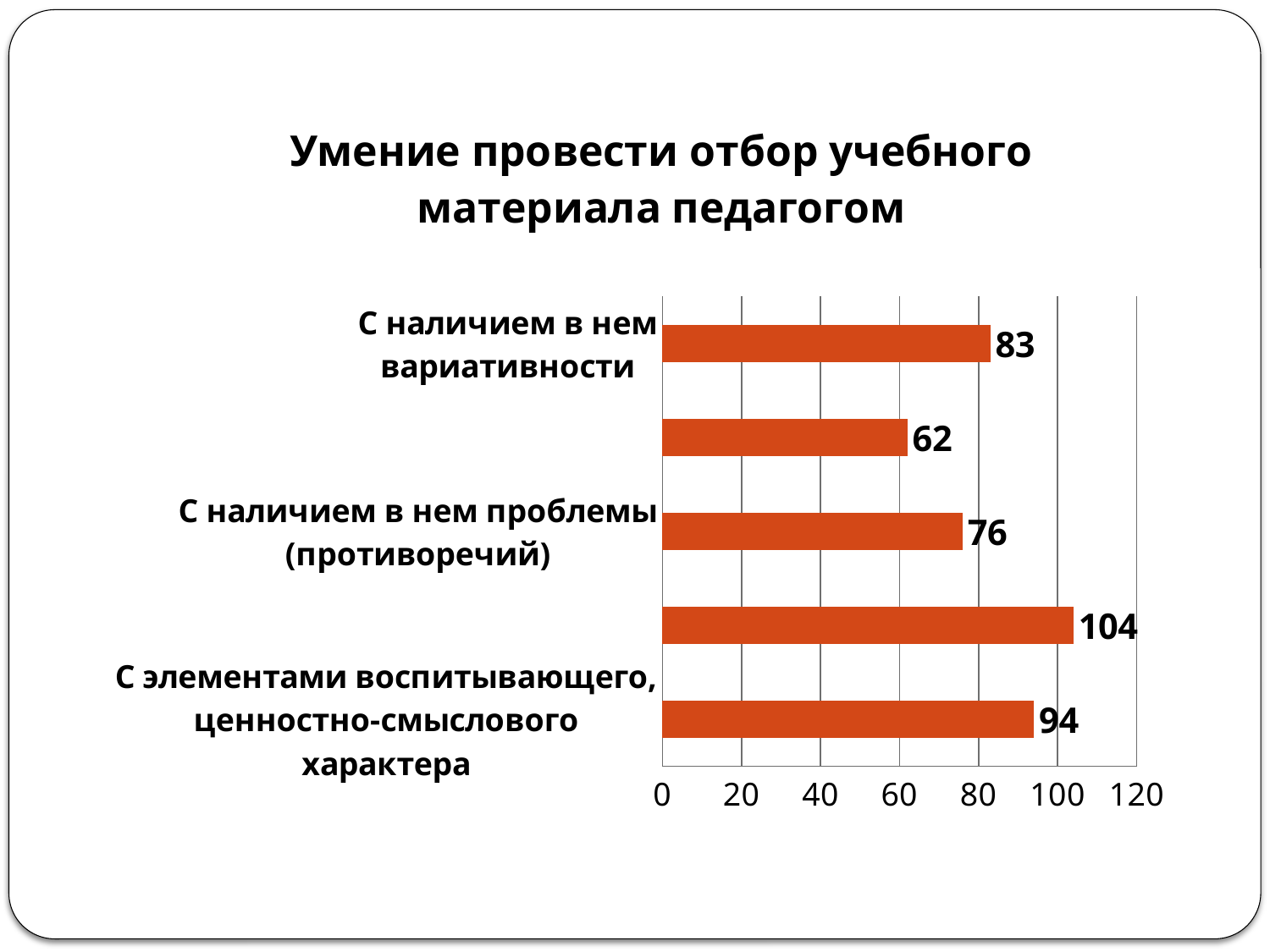
What is the value of the second bar from the top? 62 What is the value for "С элементами воспитывающего, ценностно-смыслового характера"? 94 What is the value for "С наличием в нем вариативности"? 83 What is the highest value shown on the chart? 104 How many bars are plotted on the chart? 5 Which is larger: the value for "С наличием в нем вариативности" or the value for "С наличием в нем проблемы (противоречий)"? С наличием в нем вариативности What is the value for "С наличием в нем проблемы (противоречий)"? 76 What kind of chart is shown on the slide? bar chart What is the lowest value shown on the chart? 62 Is the value of the fourth bar from the top greater or less than 100? greater What is the difference between the value for "С элементами воспитывающего, ценностно-смыслового характера" and the value for "С наличием в нем проблемы (противоречий)"? 18 What is the title of the chart? Умение провести отбор учебного материала педагогом